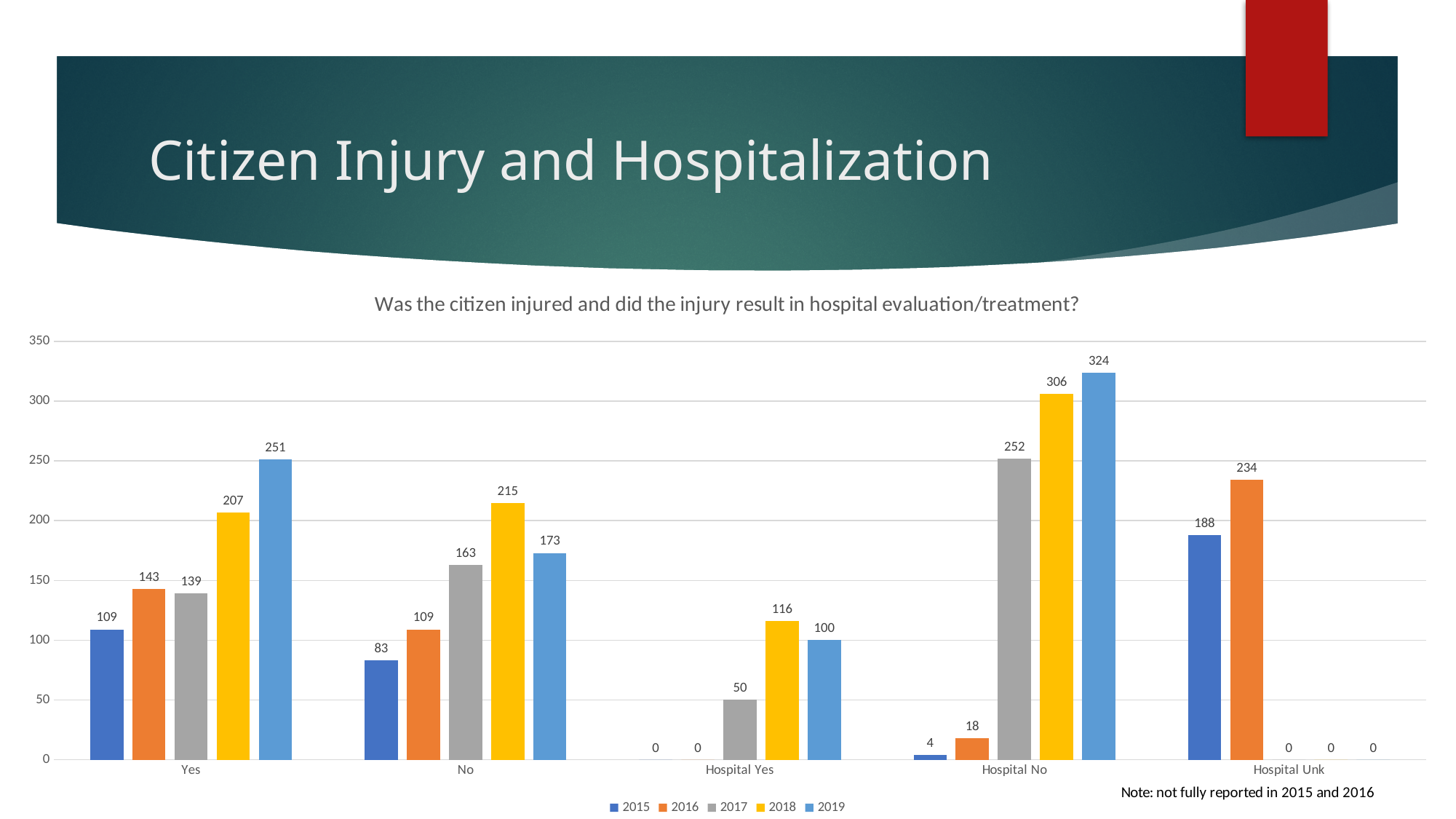
What is the value for 2019 in the Yes category? 251 How many categories are shown on the x axis? 5 What is the value for 2016 in the Hospital Unk category? 234 Which is larger in the No category: the 2018 value or the 2019 value? 2018 What is the value for 2017 in the Hospital No category? 252 How many series does the legend list? 5 Do the values for the Yes category rise or fall from 2017 to 2019? rise What kind of chart is shown on the slide? bar chart What is the difference between the 2018 and 2017 values in the Yes category? 68 Which year has the highest value in the Hospital No category? 2019 Which year has the lowest value in the No category? 2015 What is the title of the chart? Was the citizen injured and did the injury result in hospital evaluation/treatment?